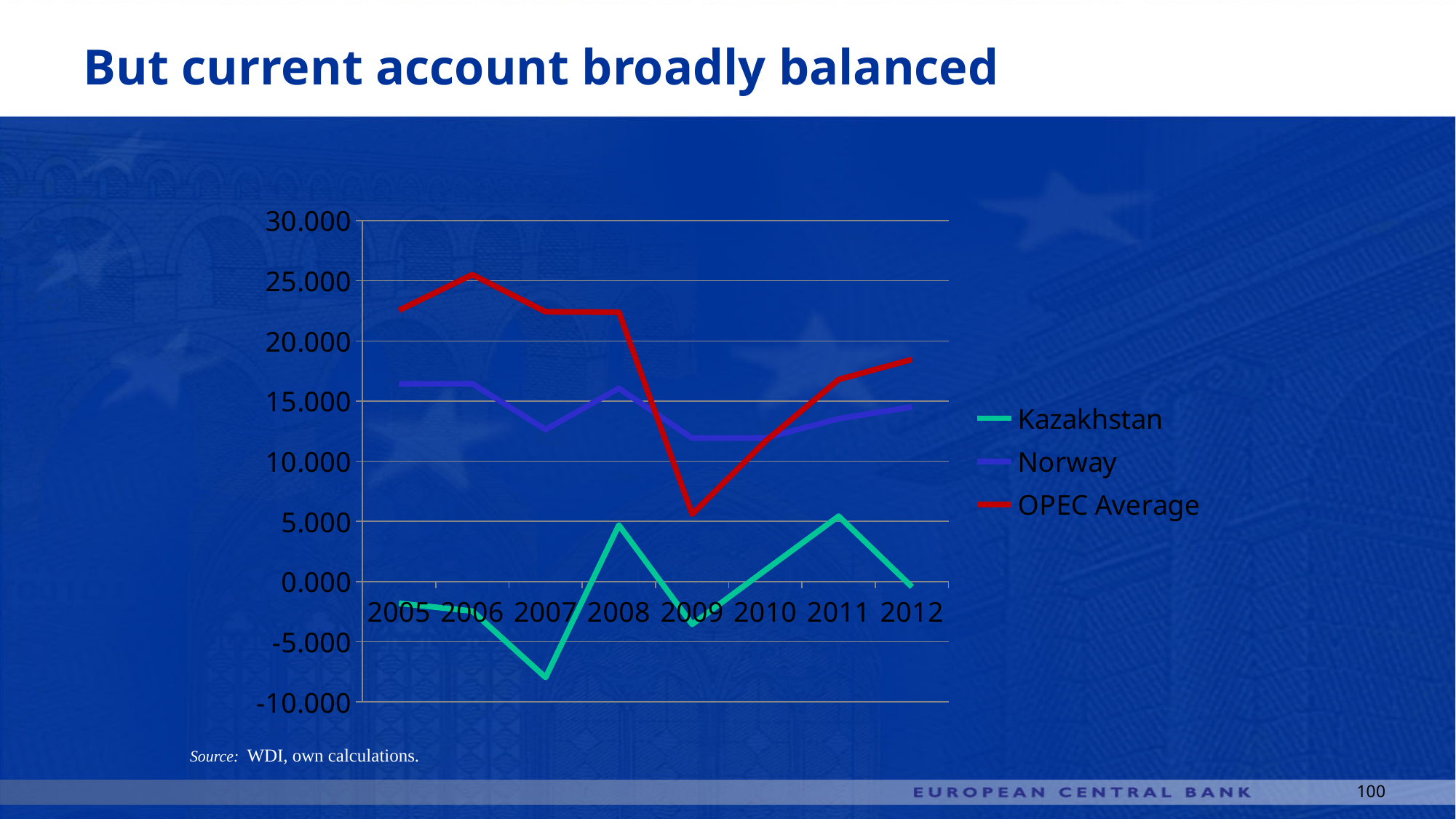
In which year is the Kazakhstan line at its lowest? 2007 In which year is the OPEC Average line at its lowest? 2009 Is the OPEC Average value for 2009 greater or less than 10.000? less In 2009, which is larger: the value for Norway or the value for OPEC Average? Norway In which year is the OPEC Average line at its highest? 2006 Does the OPEC Average line rise or fall from 2009 to 2012? rise How many series does the legend list? 3 Is the Kazakhstan value for 2007 greater or less than -5.000? less In which year is the Kazakhstan line at its highest? 2011 How many years are shown on the x axis? 8 What kind of chart is shown on the slide? line chart Is the Norway value for 2005 greater or less than 15.000? greater